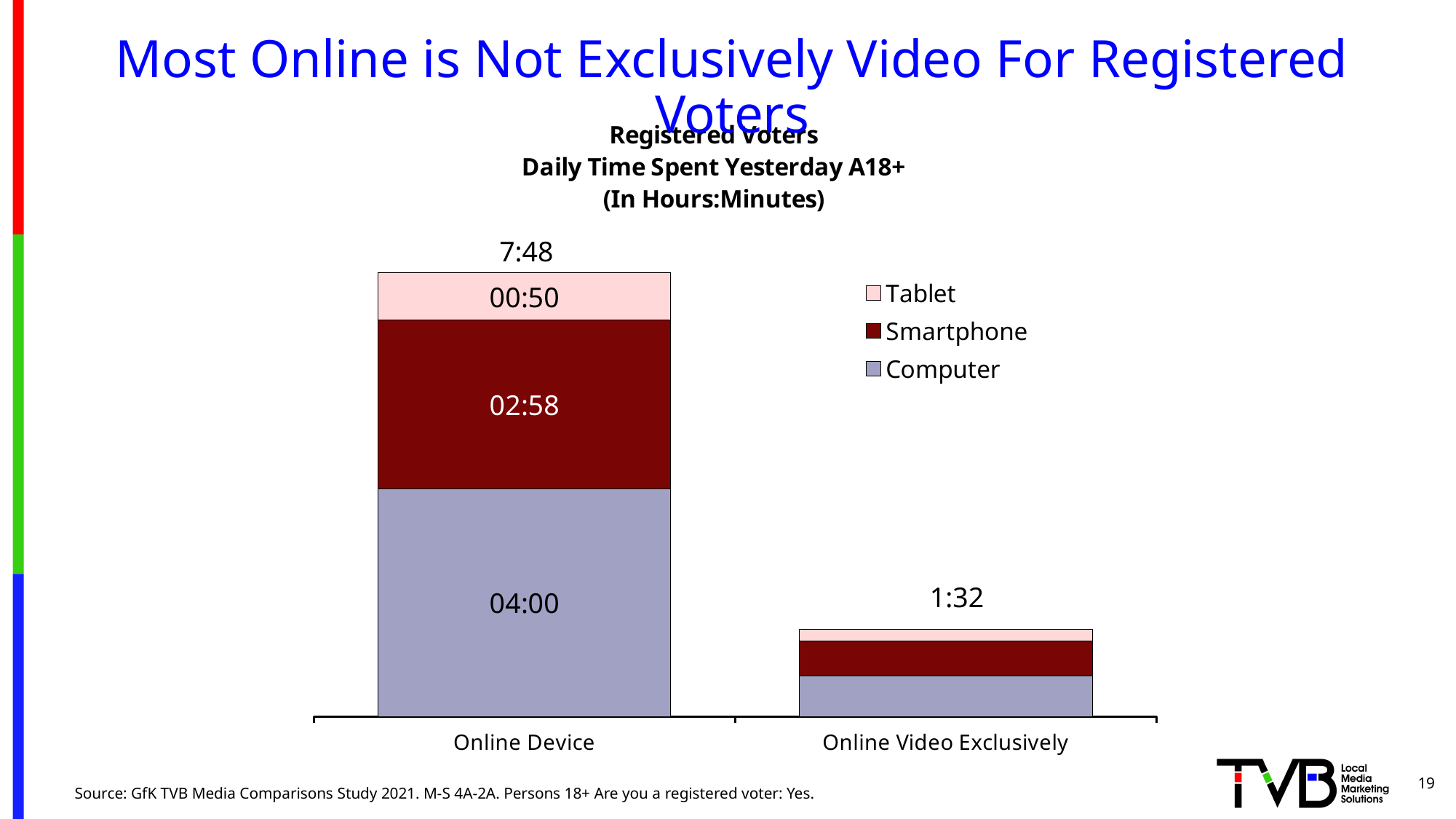
Within the Online Device bar, which device has the smallest time? Tablet What kind of chart is shown on the slide? Stacked bar chart What is the Tablet value for Online Device? 00:50 Within the Online Device bar, which device has the largest time? Computer What is the difference between the Online Device total and the Online Video Exclusively total? 6:16 What is the total time shown for the Online Device bar? 7:48 How many series does the legend list? 3 What is the total time shown for the Online Video Exclusively bar? 1:32 What is the Computer value for Online Device? 04:00 How many categories are shown on the x axis? 2 Which category has the larger total, Online Device or Online Video Exclusively? Online Device What is the Smartphone value for Online Device? 02:58